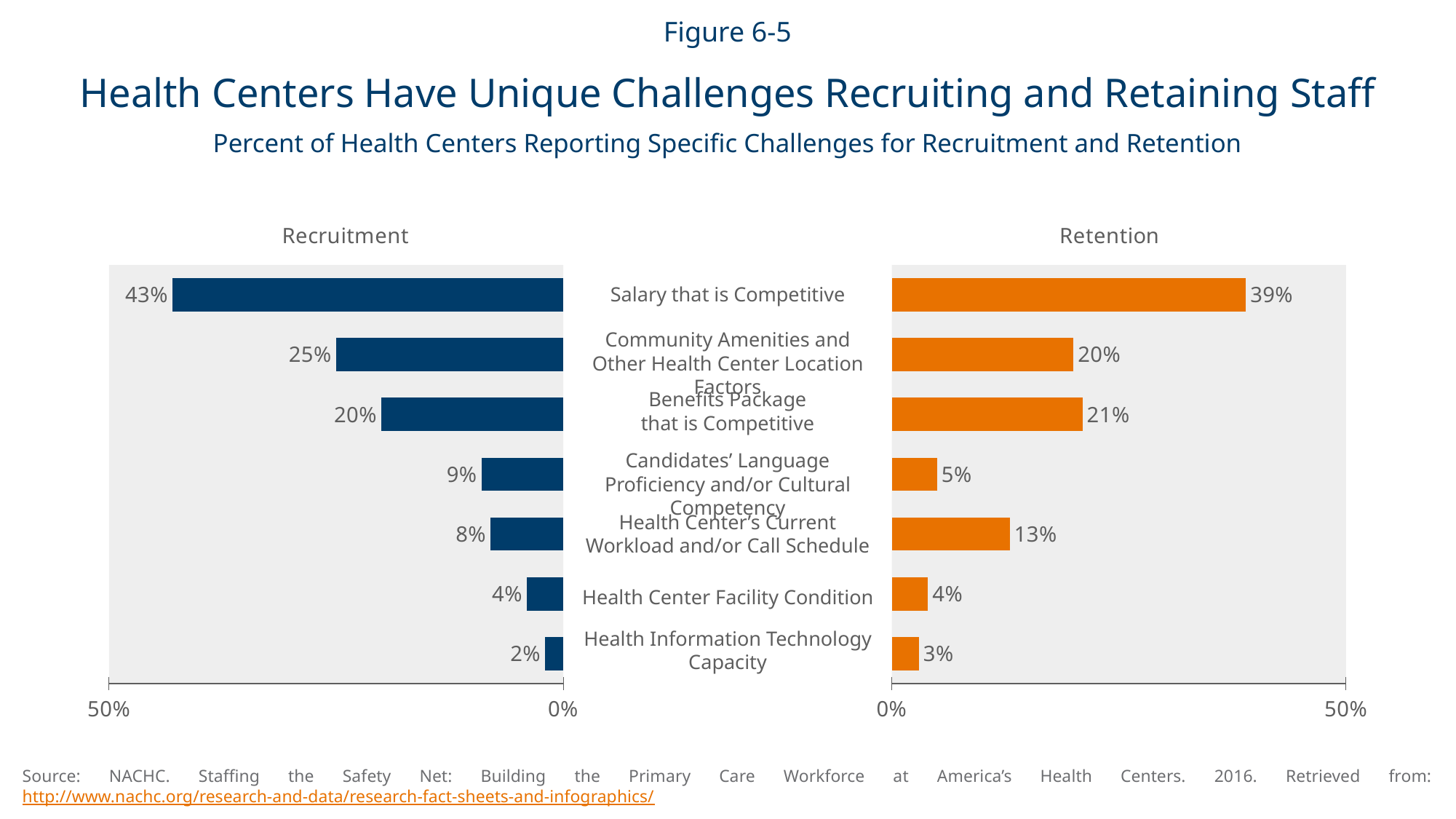
In the Retention chart, what percent of health centers reported Health Center's Current Workload and/or Call Schedule as a challenge? 13% Which is larger in the Retention chart: Community Amenities and Other Health Center Location Factors or Health Center's Current Workload and/or Call Schedule? Community Amenities and Other Health Center Location Factors What kind of chart is used for the Recruitment data? Bar chart In the Recruitment chart, which challenge has the lowest value? Health Information Technology Capacity Is the Recruitment value for Candidates' Language Proficiency and/or Cultural Competency larger or smaller than the Retention value for the same challenge? larger What colour are the bars in the Retention chart? Orange In the Recruitment chart, what percent of health centers reported Salary that is Competitive as a challenge? 43% In the Retention chart, which challenge has the highest value? Salary that is Competitive In the Recruitment chart, what is the difference between Community Amenities and Other Health Center Location Factors and Benefits Package that is Competitive? 5% In the Retention chart, what is the value for Benefits Package that is Competitive? 21% How many challenge categories are shown in the Recruitment chart? 7 What is the difference between the Recruitment and Retention values for Salary that is Competitive? 4%